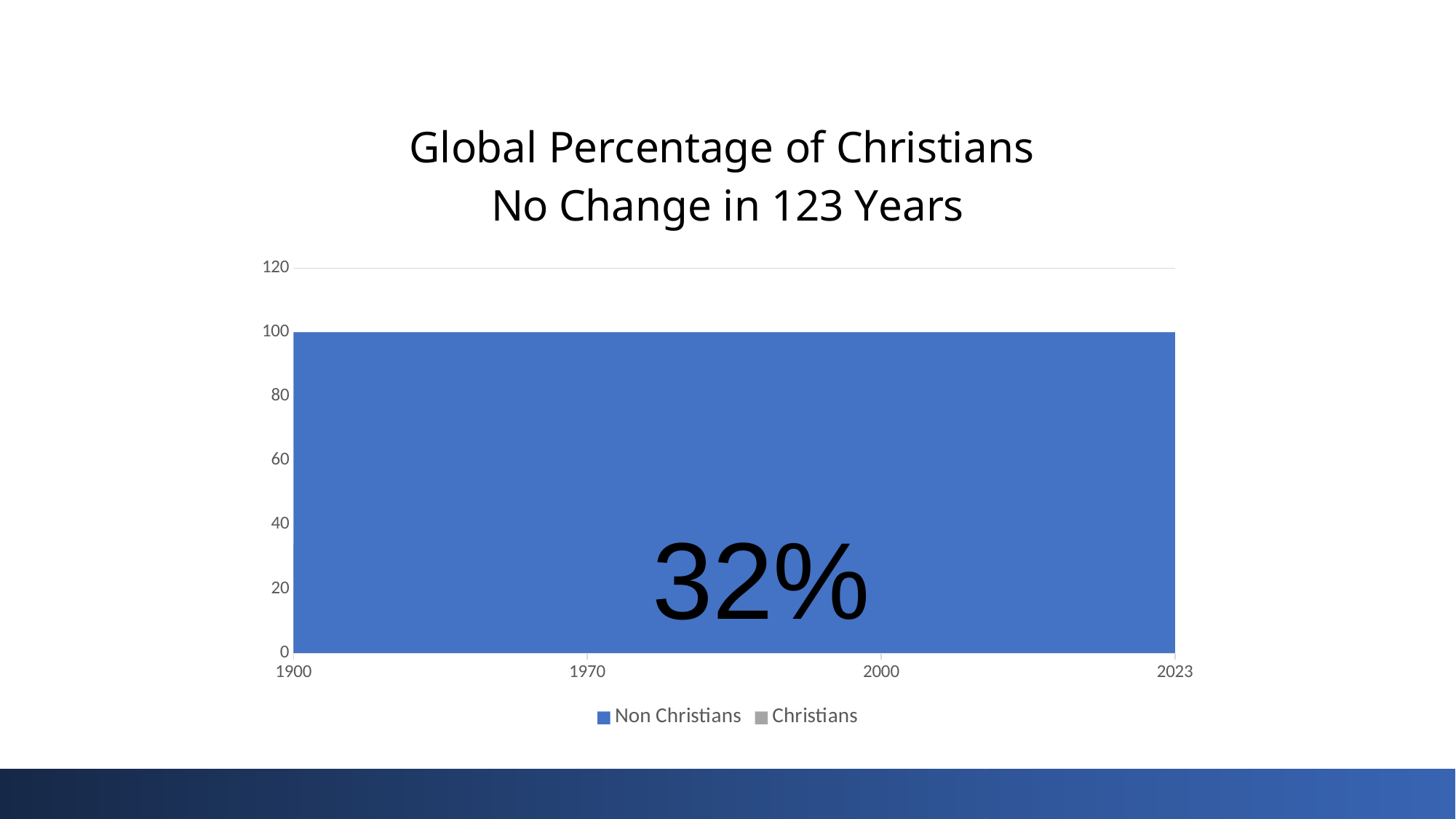
What is the title of the chart? Global Percentage of Christians No Change in 123 Years What is the first year shown on the x axis? 1900 How many series does the legend list? 2 What kind of chart is shown on the slide? area chart Is the value for Non Christians in 2023 greater or less than 120? less How many years are labelled on the x axis? 4 What is the last year shown on the x axis? 2023 Is the value for Non Christians in 1900 greater or less than 80? greater What is the highest value shown on the y axis? 120 Which series are listed in the legend? Non Christians, Christians Does the plotted area rise, fall, or stay flat from 1900 to 2023? stays flat What percentage is printed in large text on the chart? 32%